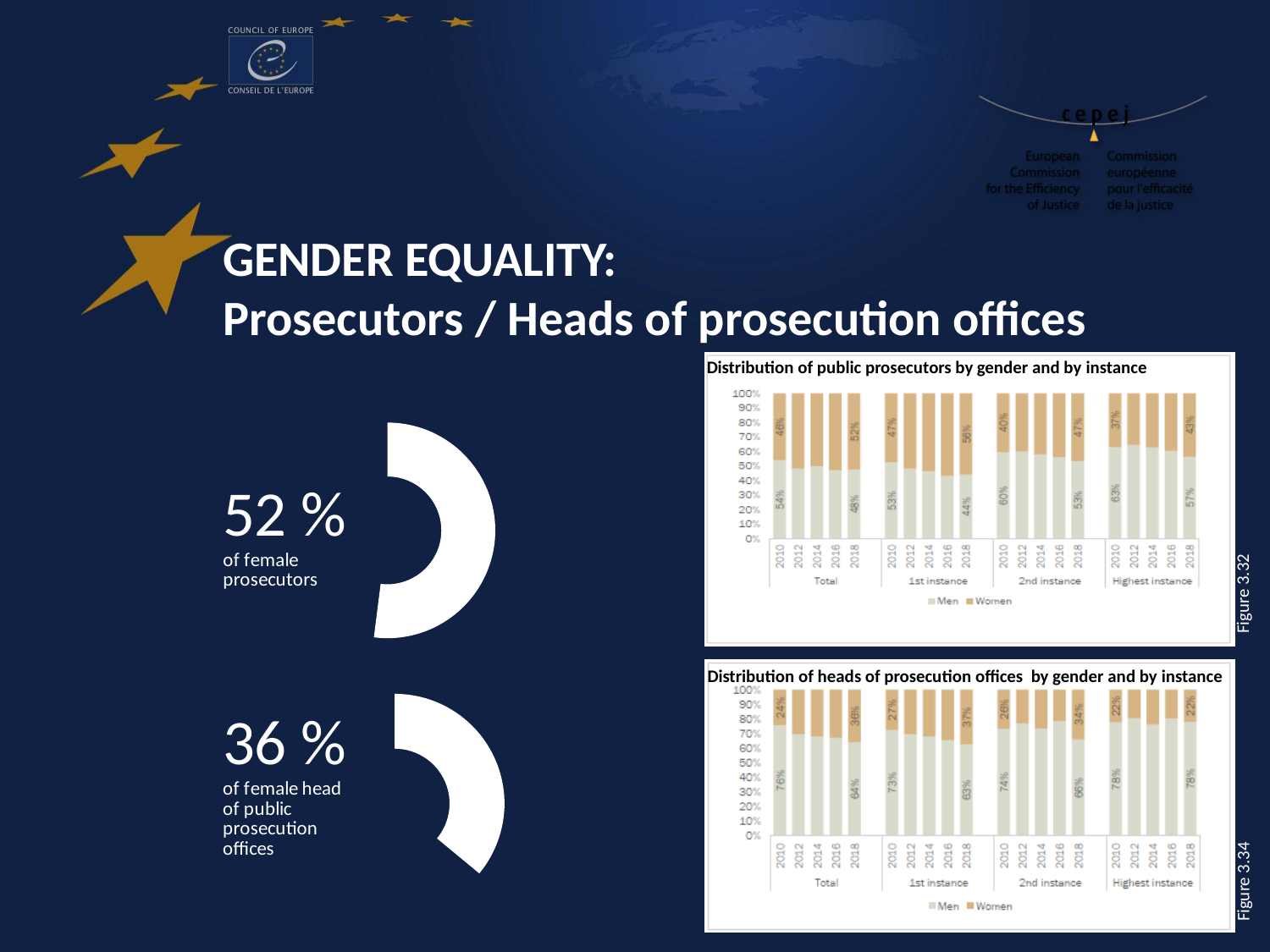
In the chart 'Distribution of public prosecutors by gender and by instance', what is the share of women in the 1st instance group in 2018? 56% In the chart 'Distribution of heads of prosecution offices by gender and by instance', what is the share of women in the Total group in 2018? 36% In the chart 'Distribution of public prosecutors by gender and by instance', by how many percentage points did the share of women in the 2nd instance group change between 2010 and 2018? 7 percentage points In the chart 'Distribution of public prosecutors by gender and by instance', how many series does the legend list? 2 In the chart 'Distribution of public prosecutors by gender and by instance', which is larger in 2018: the share of women in the 1st instance group or in the Highest instance group? 1st instance In the chart 'Distribution of public prosecutors by gender and by instance', what is the share of men in the Highest instance group in 2010? 63% In the chart 'Distribution of public prosecutors by gender and by instance', what is the share of women in the Total group in 2018? 52% In the chart 'Distribution of heads of prosecution offices by gender and by instance', which instance group has the lowest share of women in 2018? Highest instance What kind of chart is 'Distribution of heads of prosecution offices by gender and by instance'? Stacked bar chart In the chart 'Distribution of heads of prosecution offices by gender and by instance', what is the difference between the share of men and the share of women in the 1st instance group in 2010? 46 percentage points In the chart 'Distribution of heads of prosecution offices by gender and by instance', what is the share of men in the Highest instance group in 2018? 78% In the chart 'Distribution of heads of prosecution offices by gender and by instance', how many instance groups are shown on the x axis? 4